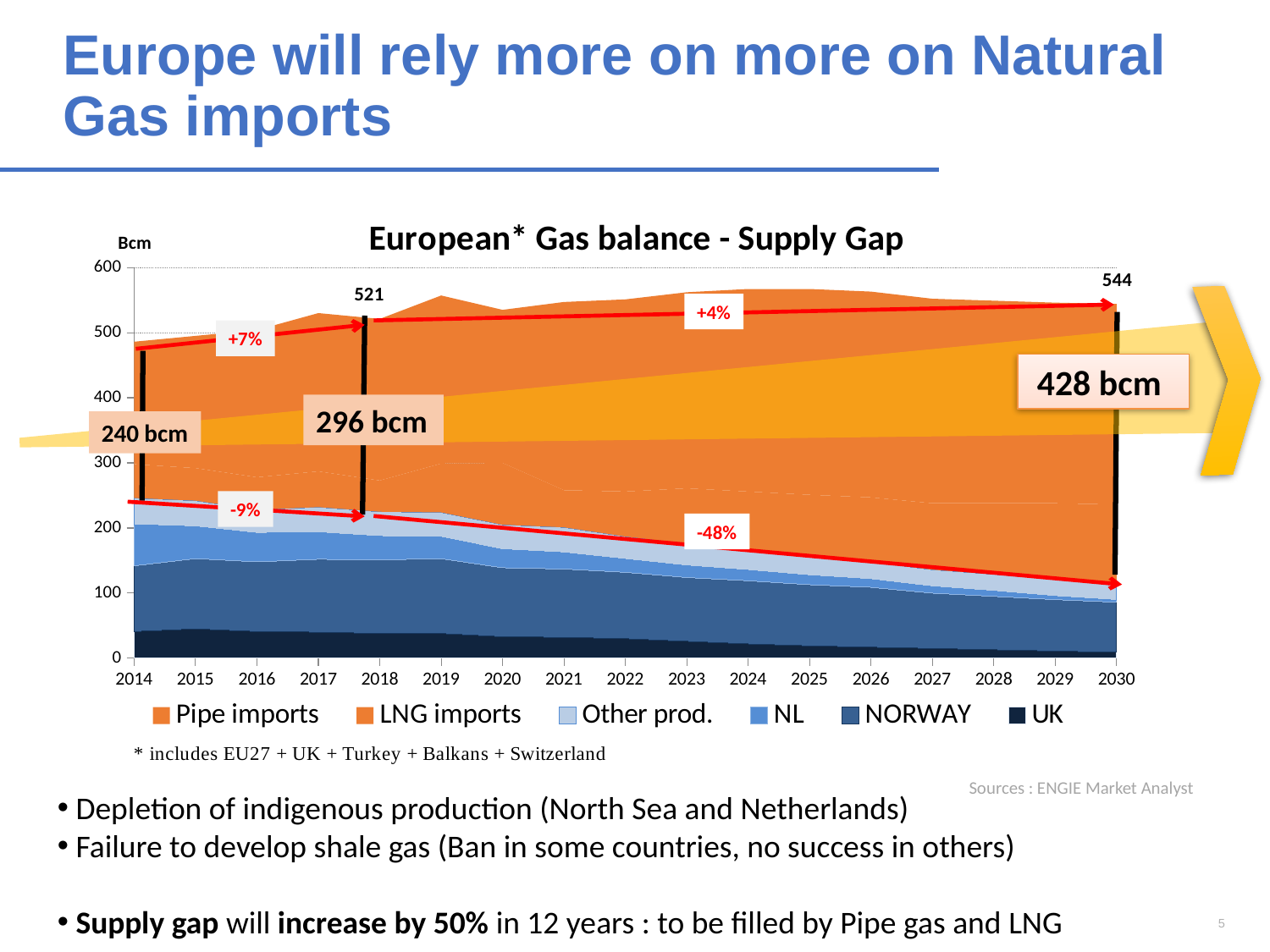
What is the supply gap labelled on the chart for 2030? 428 bcm By how much does the labelled supply gap grow from 2014 (240 bcm) to 2030 (428 bcm)? 188 bcm What is the title of the chart? European* Gas balance - Supply Gap What type of chart is shown on the slide? Area chart What is the difference between the labelled totals for 2030 (544) and 2018 (521)? 23 What is the supply gap labelled on the chart for 2014? 240 bcm How many series does the chart legend list? 6 Is the value for UK production in 2014 greater or less than 100? less How many years are shown along the x axis of the chart? 17 What total value is labelled on the chart for 2030? 544 What total value is labelled on the chart for 2018? 521 Does the combined indigenous production (UK, NORWAY, NL, Other prod.) rise or fall from 2014 to 2030? Fall